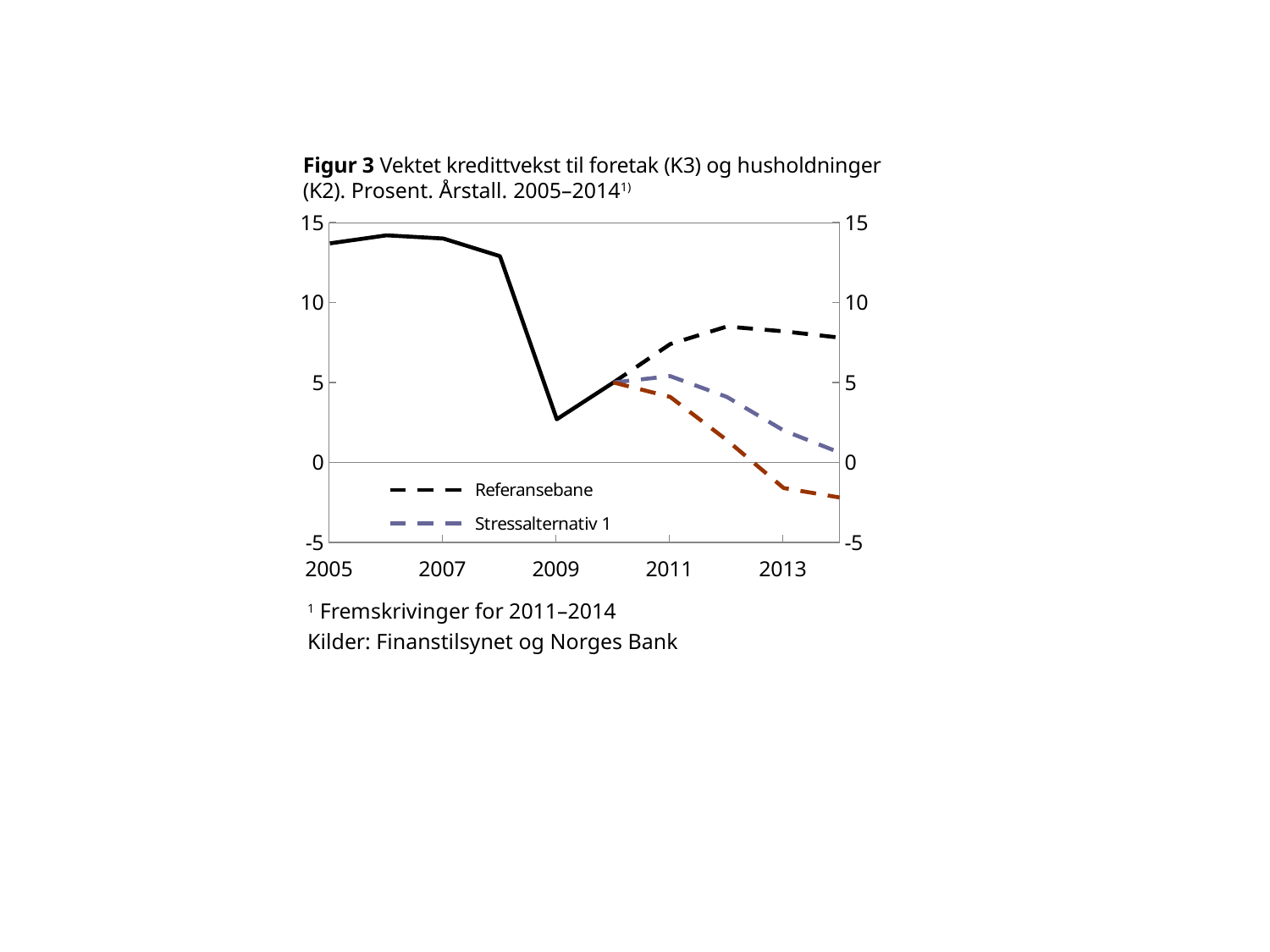
How many series does the legend list? 2 Is the value for Referansebane in 2012 greater or less than 5? greater What are the two series named in the legend? Referansebane and Stressalternativ 1 What kind of chart is shown on the slide? line chart Is the value of the solid line in 2009 greater or less than 5? less Does the Stressalternativ 1 line rise or fall from 2011 to 2014? fall Does the solid line rise or fall from 2008 to 2009? fall In which year does the solid line reach its lowest point? 2009 What is the highest value shown on the left vertical axis? 15 Is the value of the solid line in 2005 greater or less than 10? greater In 2014, which series is higher: Referansebane or Stressalternativ 1? Referansebane